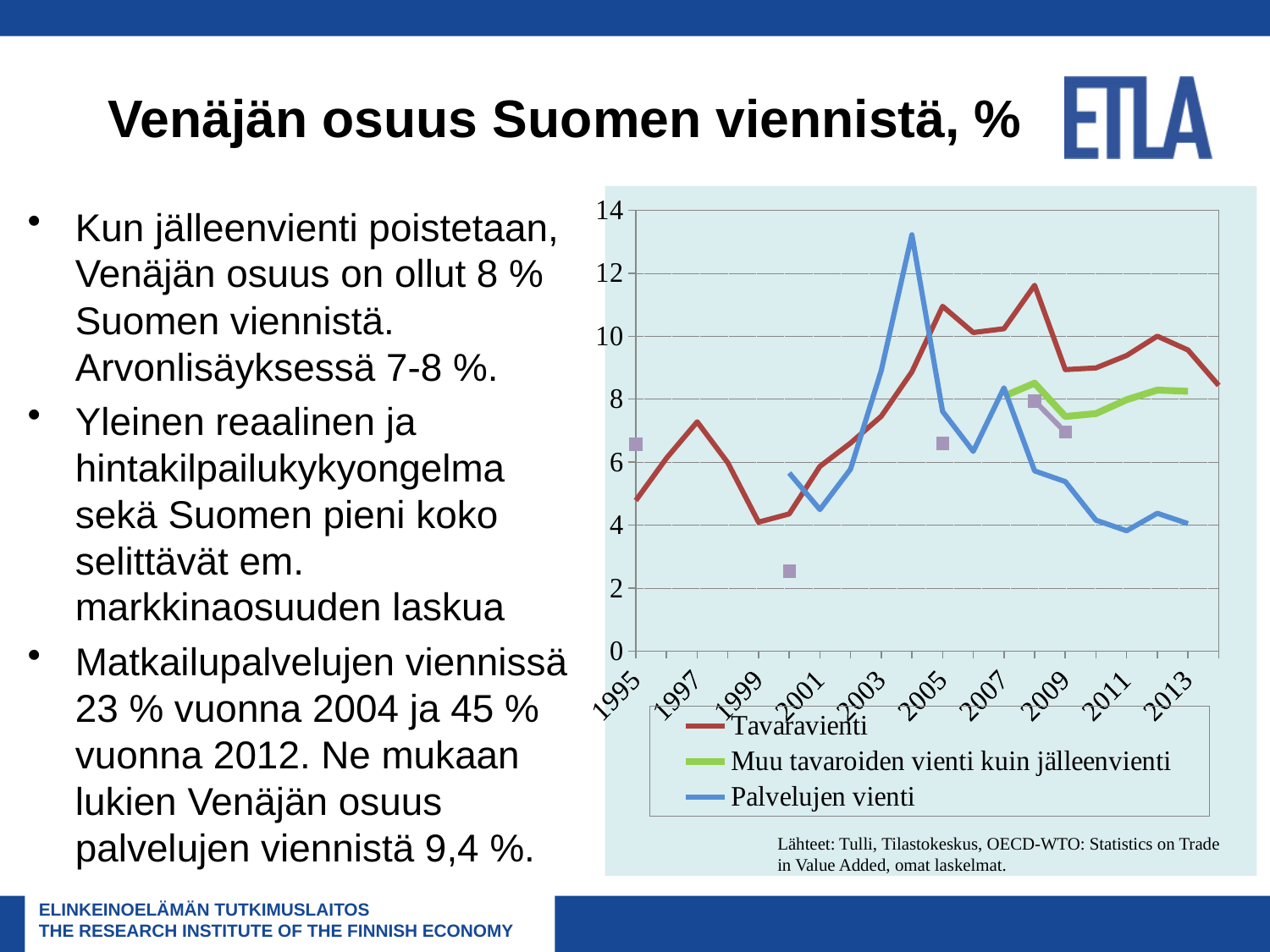
Is the value for Palvelujen vienti in 2011 greater or less than 6? less In which year does Palvelujen vienti reach its highest value? 2004 How many series does the chart legend list? 3 Is the value for Palvelujen vienti in 2005 greater or less than 12? less Is the value for Tavaravienti in 1999 greater or less than 6? less What kind of chart is shown on the slide? line chart What is the title of the chart? Venäjän osuus Suomen viennistä, % Which series is drawn with the green line? Muu tavaroiden vienti kuin jälleenvienti In 2013, which is larger: Tavaravienti or Palvelujen vienti? Tavaravienti Does Palvelujen vienti rise or fall between 2005 and 2011? fall